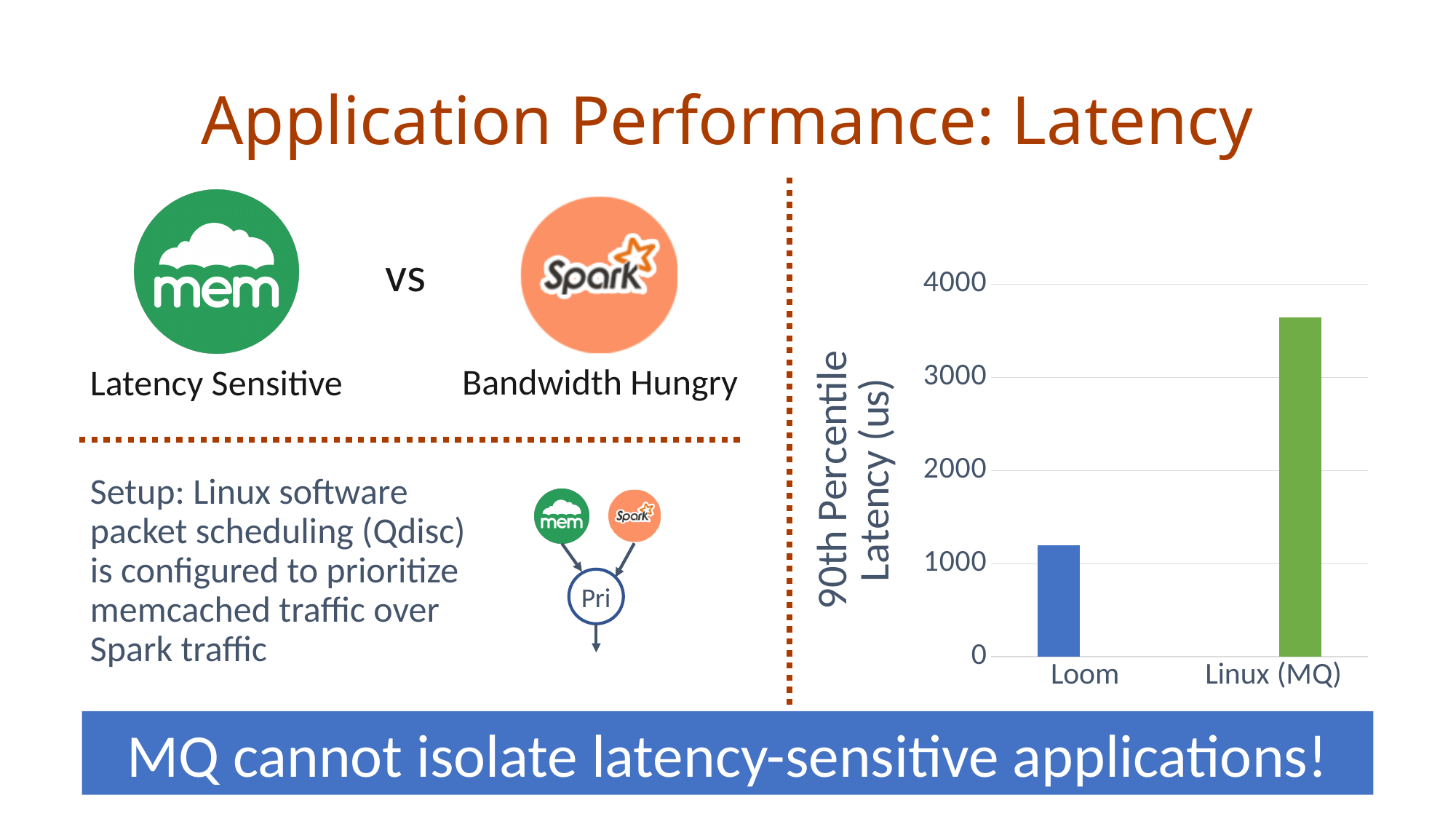
How many categories are plotted on the x axis of the chart? 2 Is the 90th percentile latency for Loom greater or less than 2000? less Is the 90th percentile latency for Loom greater or less than 1000? greater Which category has the highest 90th percentile latency? Linux (MQ) Which has a larger 90th percentile latency, Loom or Linux (MQ)? Linux (MQ) What kind of chart is shown on the slide? bar chart What is the highest tick value shown on the y axis? 4000 What is the label of the y axis of the chart? 90th Percentile Latency (us) Which category has the lowest 90th percentile latency? Loom What colour is the bar for Linux (MQ)? green Is the 90th percentile latency for Linux (MQ) greater or less than 3000? greater